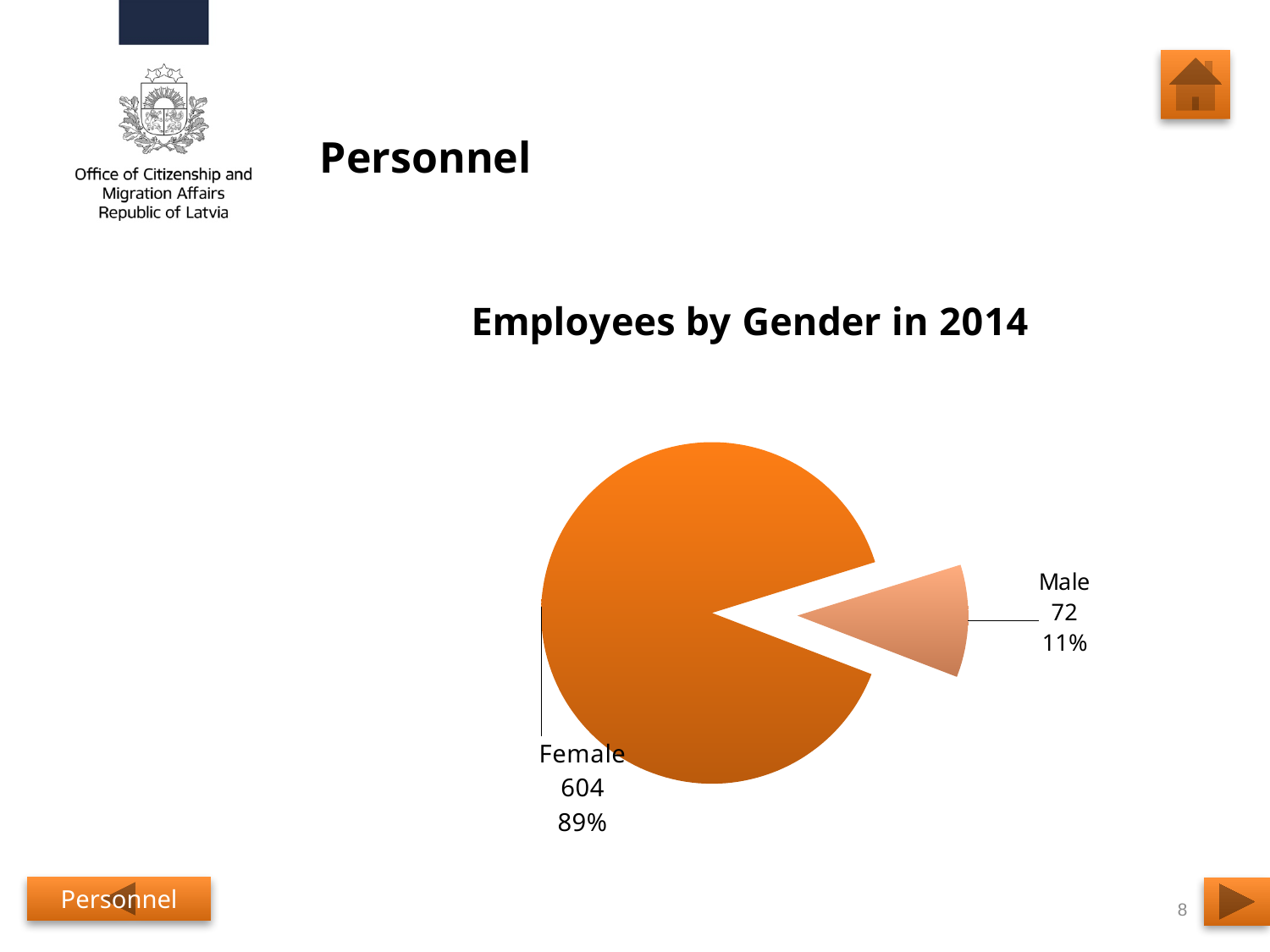
What kind of chart is shown on the slide? pie chart How many more female employees are there than male employees? 532 Which gender has the larger number of employees? Female How many slices does the pie chart have? 2 Which slice is pulled out from the rest of the pie? Male What is the title of the chart? Employees by Gender in 2014 What is the total number of employees shown in the chart? 676 How many employees are female according to the chart? 604 What share of employees is female? 89% What share of employees is male? 11% Which gender has the smaller number of employees? Male How many employees are male according to the chart? 72